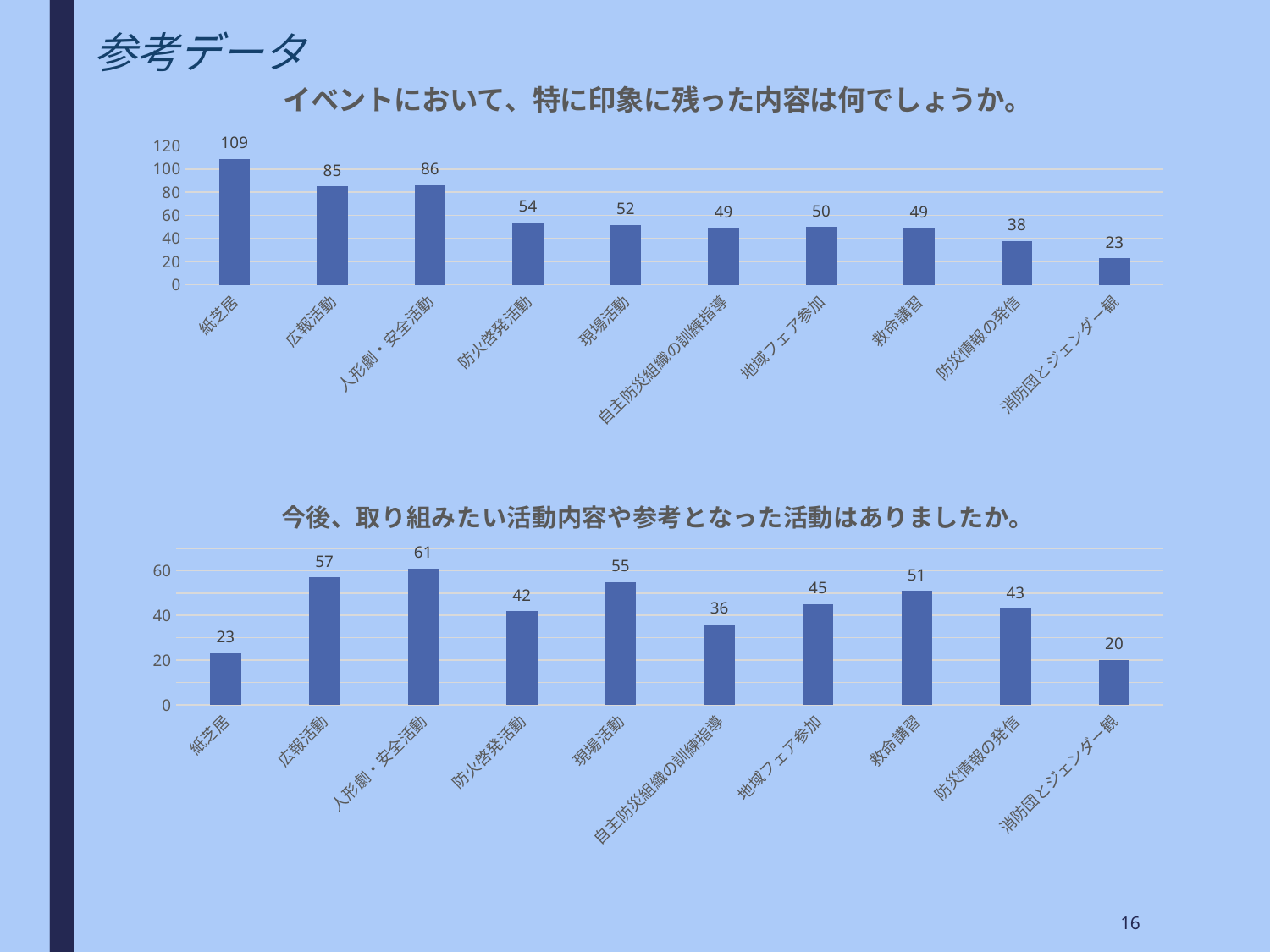
What kind of chart is the bottom chart? Bar chart In the top chart, how many categories are shown? 10 In the top chart, what is the difference between the values for 紙芝居 and 広報活動? 24 In the top chart (イベントにおいて、特に印象に残った内容は何でしょうか。), what is the value for 紙芝居? 109 In the bottom chart (今後、取り組みたい活動内容や参考となった活動はありましたか。), what is the value for 人形劇・安全活動? 61 In the top chart, which category has the lowest value? 消防団とジェンダー観 In the bottom chart, which category has the lowest value? 消防団とジェンダー観 In the bottom chart, what is the difference between the values for 現場活動 and 防火啓発活動? 13 In the top chart, what is the value for 防災情報の発信? 38 In the bottom chart, which is larger, the value for 救命講習 or the value for 自主防災組織の訓練指導? 救命講習 In the bottom chart, which category has the highest value? 人形劇・安全活動 In the top chart, which category has the highest value? 紙芝居